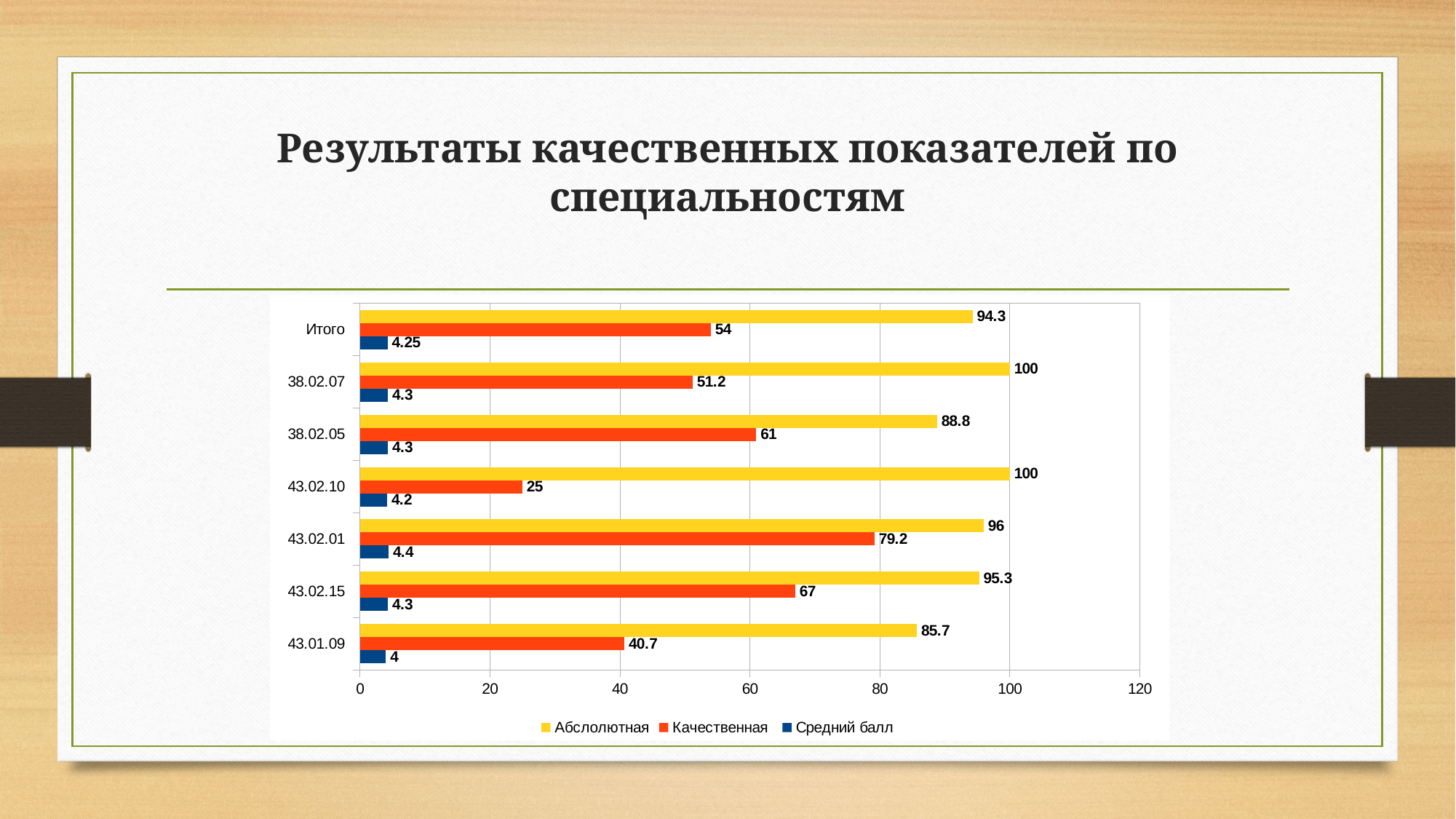
What kind of chart is shown on the slide? bar chart What is the difference between the Абслолютная and Качественная values for 43.01.09? 45 Which is larger, the Качественная value for 43.02.15 or for 38.02.05? 43.02.15 How many series does the legend list? 3 What is the Качественная value for 43.02.10? 25 How many categories are shown on the y axis? 7 What is the Средний балл value for Итого? 4.25 What is the Абслолютная value for 43.02.01? 96 Which category has the lowest Качественная value? 43.02.10 What colour are the bars for the Качественная series? orange Which category has the lowest Средний балл value? 43.01.09 Which category has the highest Качественная value? 43.02.01